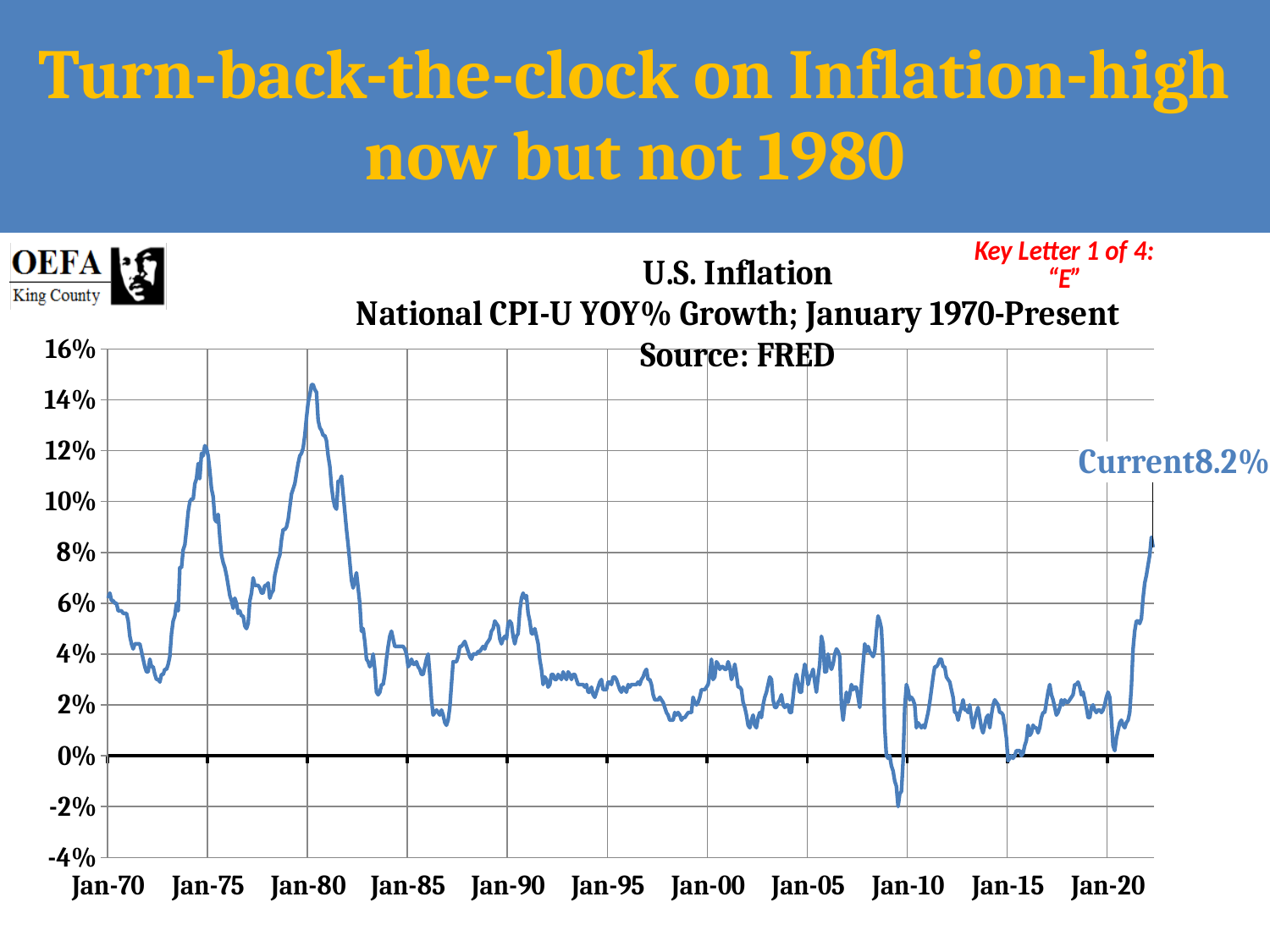
Is the current inflation value greater or less than 10%? less What is the title of the chart? U.S. Inflation How many year labels are shown on the x axis? 11 Is the lowest inflation value between Jan-05 and Jan-10 greater or less than 0%? less What is the current U.S. inflation value labelled on the chart? 8.2% Does inflation rise or fall between Jan-80 and Jan-85? fall What source is cited for the chart data? FRED Is the peak inflation value around Jan-75 greater or less than 10%? greater Around which x-axis label does the inflation line reach its highest point? Jan-80 Which is higher: the inflation peak around Jan-80 or the current value of 8.2%? the peak around Jan-80 What kind of chart is shown on the slide? line chart